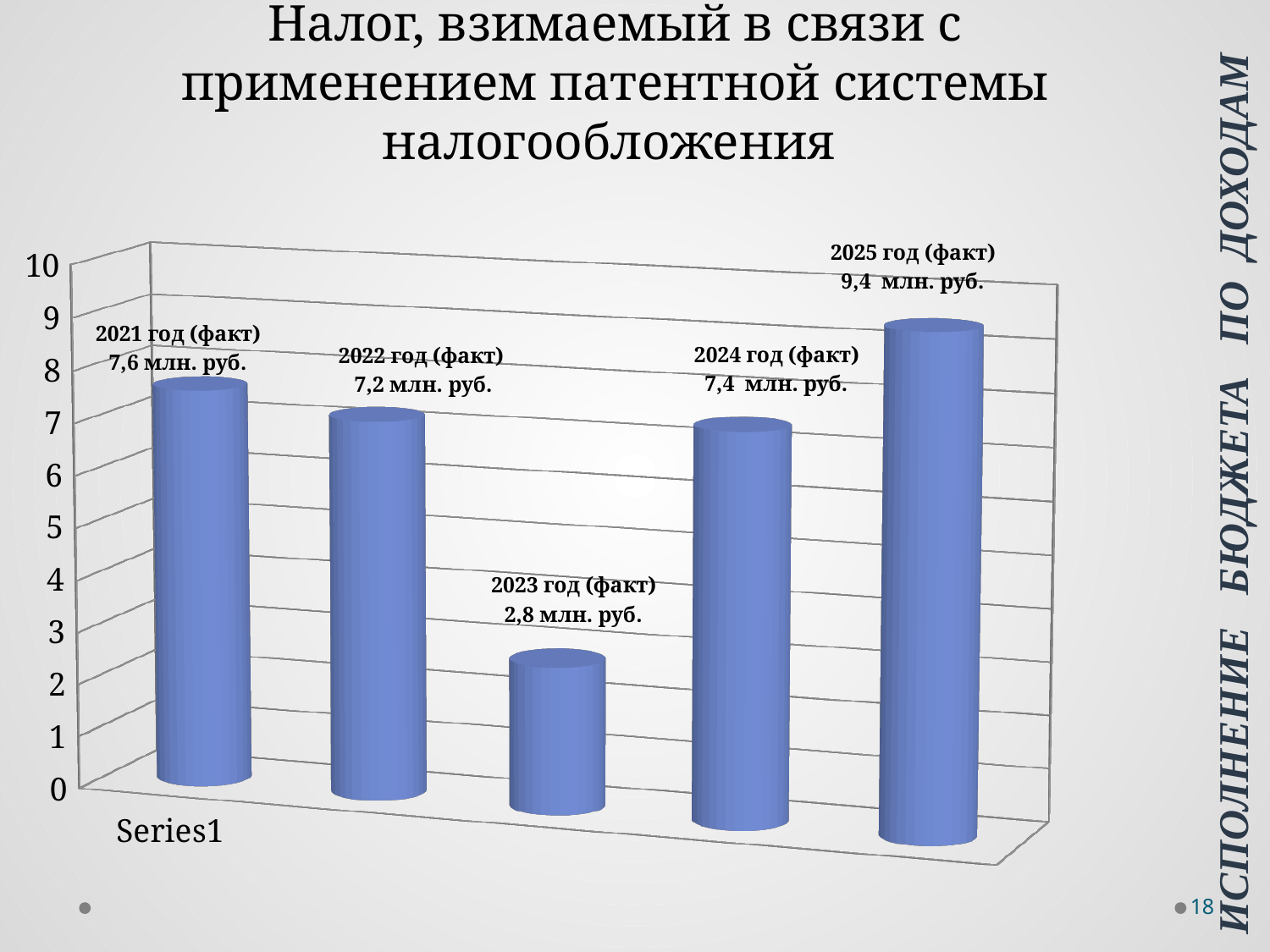
How many bars are shown in the chart? 5 What is the difference between the values for 2021 год (факт) and 2022 год (факт)? 0,4 млн. руб. Is the value for 2023 год (факт) greater or less than 5? less Which year has the lowest value? 2023 год (факт) What is the title of the chart? Налог, взимаемый в связи с применением патентной системы налогообложения Which year has the highest value? 2025 год (факт) What is the value for 2025 год (факт)? 9,4 млн. руб. What is the difference between the values for 2025 год (факт) and 2024 год (факт)? 2,0 млн. руб. Which is larger, the value for 2022 год (факт) or 2024 год (факт)? 2024 год (факт) What is the value for 2023 год (факт)? 2,8 млн. руб. What is the value for 2021 год (факт)? 7,6 млн. руб. What kind of chart is shown on the slide? bar chart